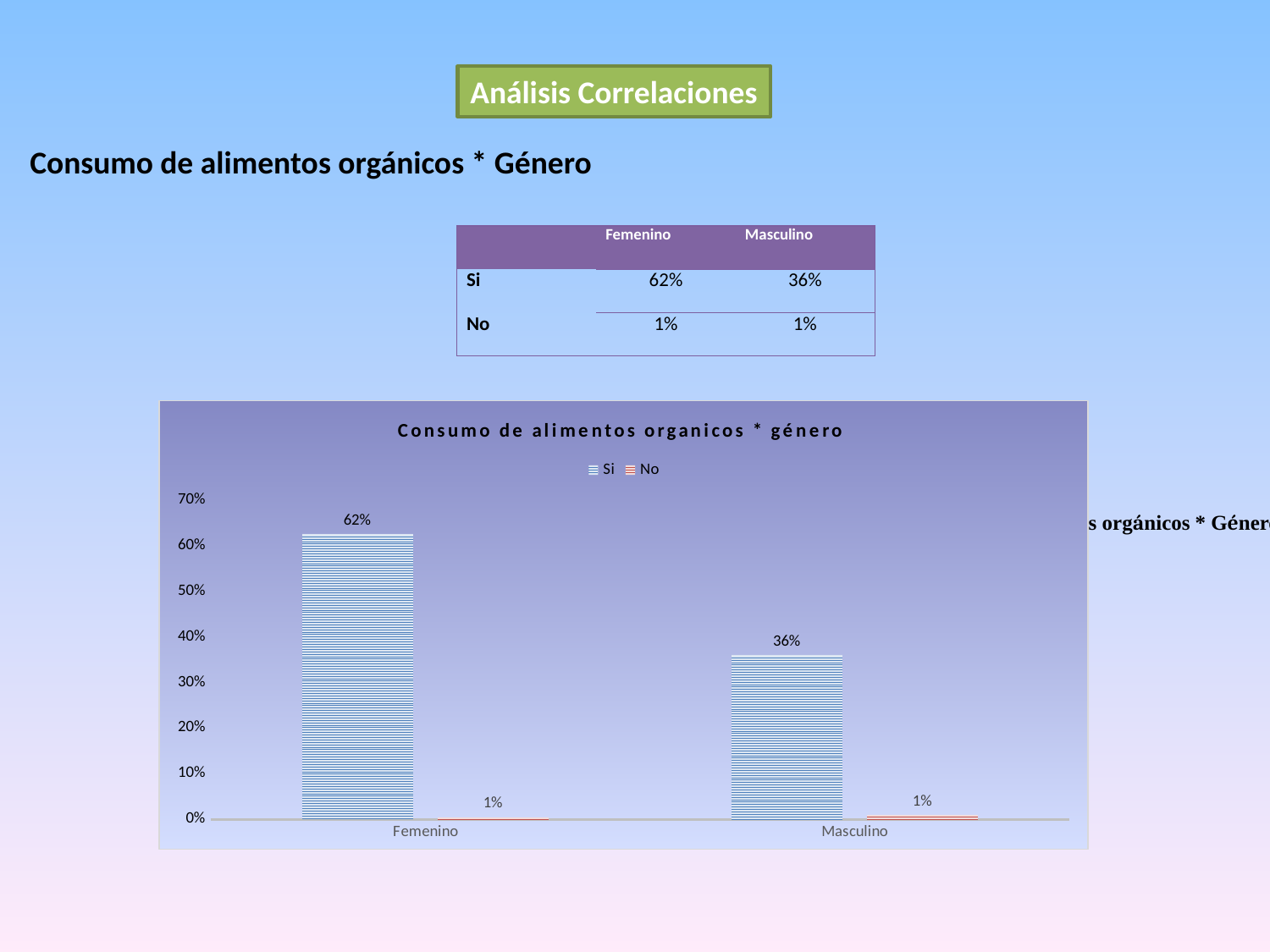
What is the value of the Si series for Masculino? 36% What is the value of the No series for Femenino? 1% What is the value of the Si series for Femenino? 62% What kind of chart is shown? bar chart How many categories are shown on the x axis? 2 Which category has the highest value for the Si series? Femenino Which is larger: the Si value for Femenino or the Si value for Masculino? Femenino What is the difference between the Si values for Femenino and Masculino? 26% What is the title of the chart? Consumo de alimentos organicos * género How many series does the legend list? 2 What are the two series named in the legend? Si and No Is the Si value for Masculino greater or less than 40%? less